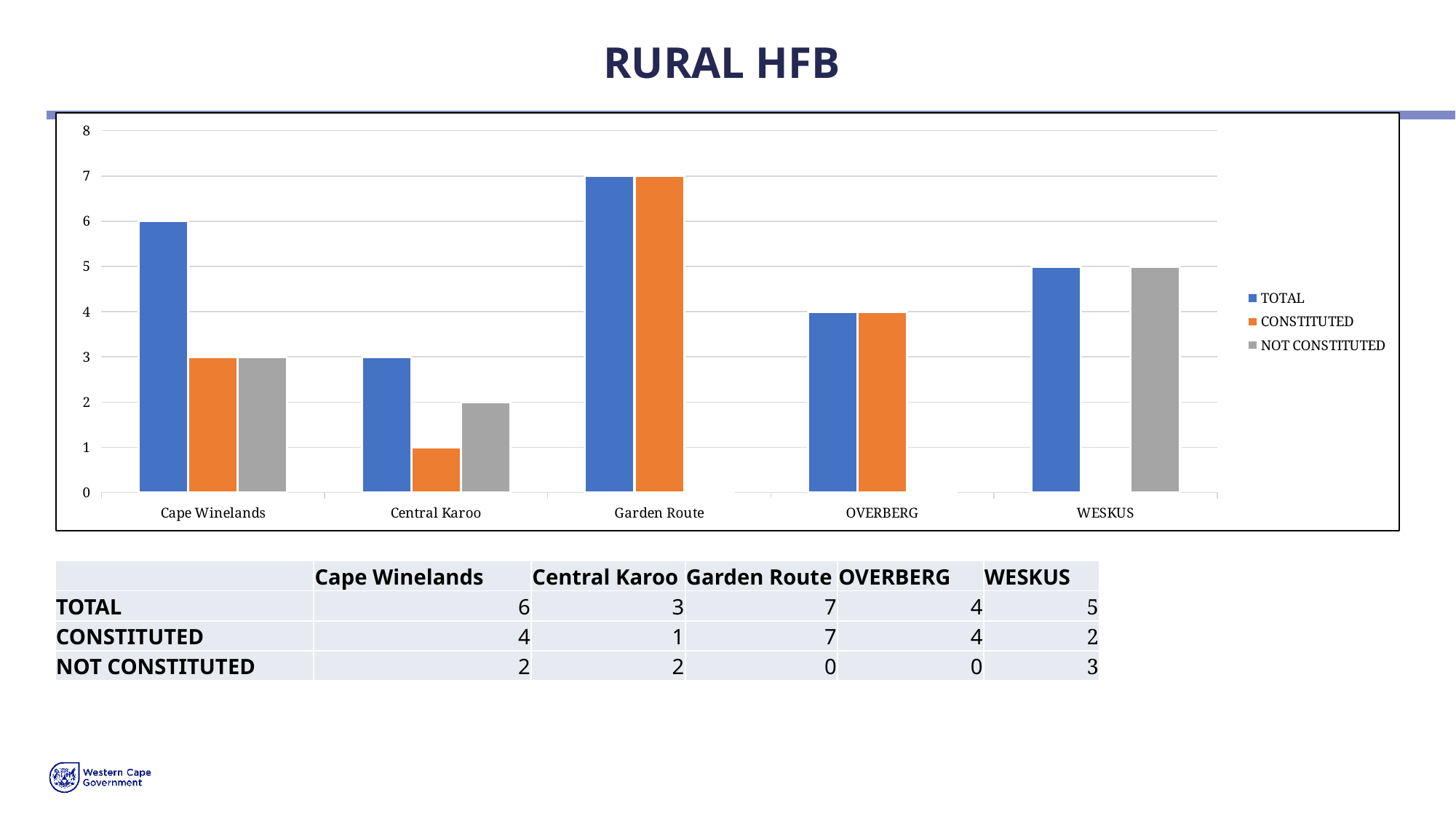
What is the difference between the TOTAL value for Garden Route and the TOTAL value for Central Karoo? 4 What kind of chart is shown on the slide? bar chart What is the NOT CONSTITUTED value for Central Karoo? 2 What is the TOTAL value for Garden Route? 7 Which category has the highest TOTAL value? Garden Route How many categories are shown on the x axis of the chart? 5 Which category has the lowest TOTAL value? Central Karoo What are the three series named in the legend? TOTAL, CONSTITUTED, NOT CONSTITUTED Which has the larger TOTAL value, Cape Winelands or WESKUS? Cape Winelands What is the CONSTITUTED value for Central Karoo? 1 How many series does the legend list? 3 What is the CONSTITUTED value for OVERBERG? 4